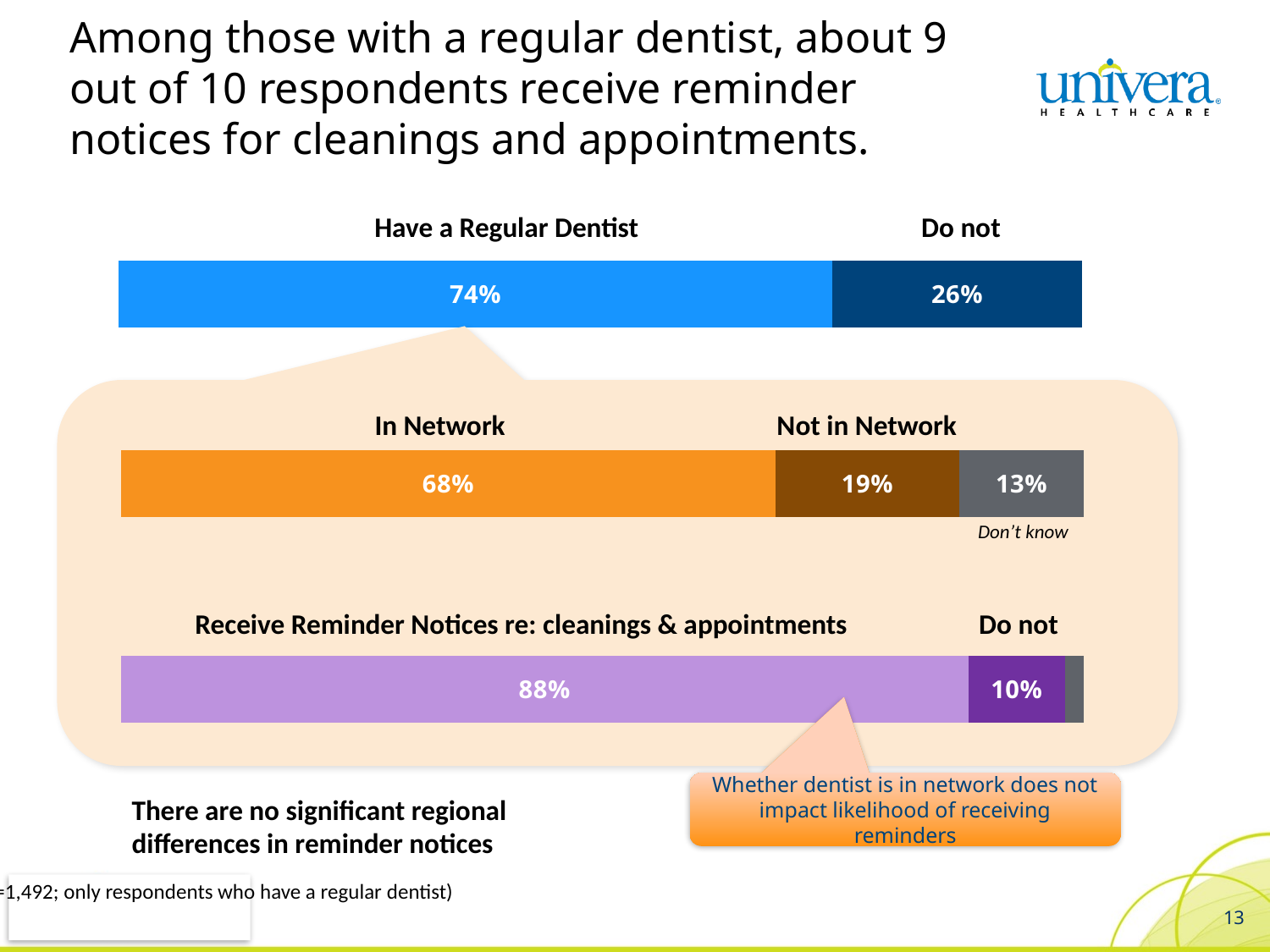
What type of chart is used to show the 'Have a Regular Dentist' data? Bar chart In the top bar chart, what percentage of respondents do not have a regular dentist? 26% In the middle bar chart, which segment is the largest? In Network In the top bar chart, what percentage of respondents have a regular dentist? 74% In the bottom bar chart, what percentage of respondents do not receive reminder notices? 10% In the top bar chart, what is the difference between the share who have a regular dentist and the share who do not? 48% In the middle bar chart, what percentage of respondents answered 'Don't know' about whether their dentist is in network? 13% In the middle bar chart, which segment is the smallest? Don't know In the middle bar chart, what is the difference between the 'In Network' and 'Not in Network' shares? 49% In the bottom bar chart, what percentage of respondents receive reminder notices for cleanings and appointments? 88% In the middle bar chart, what percentage of respondents have a dentist who is not in network? 19% In the middle bar chart, what percentage of respondents have a dentist who is in network? 68%